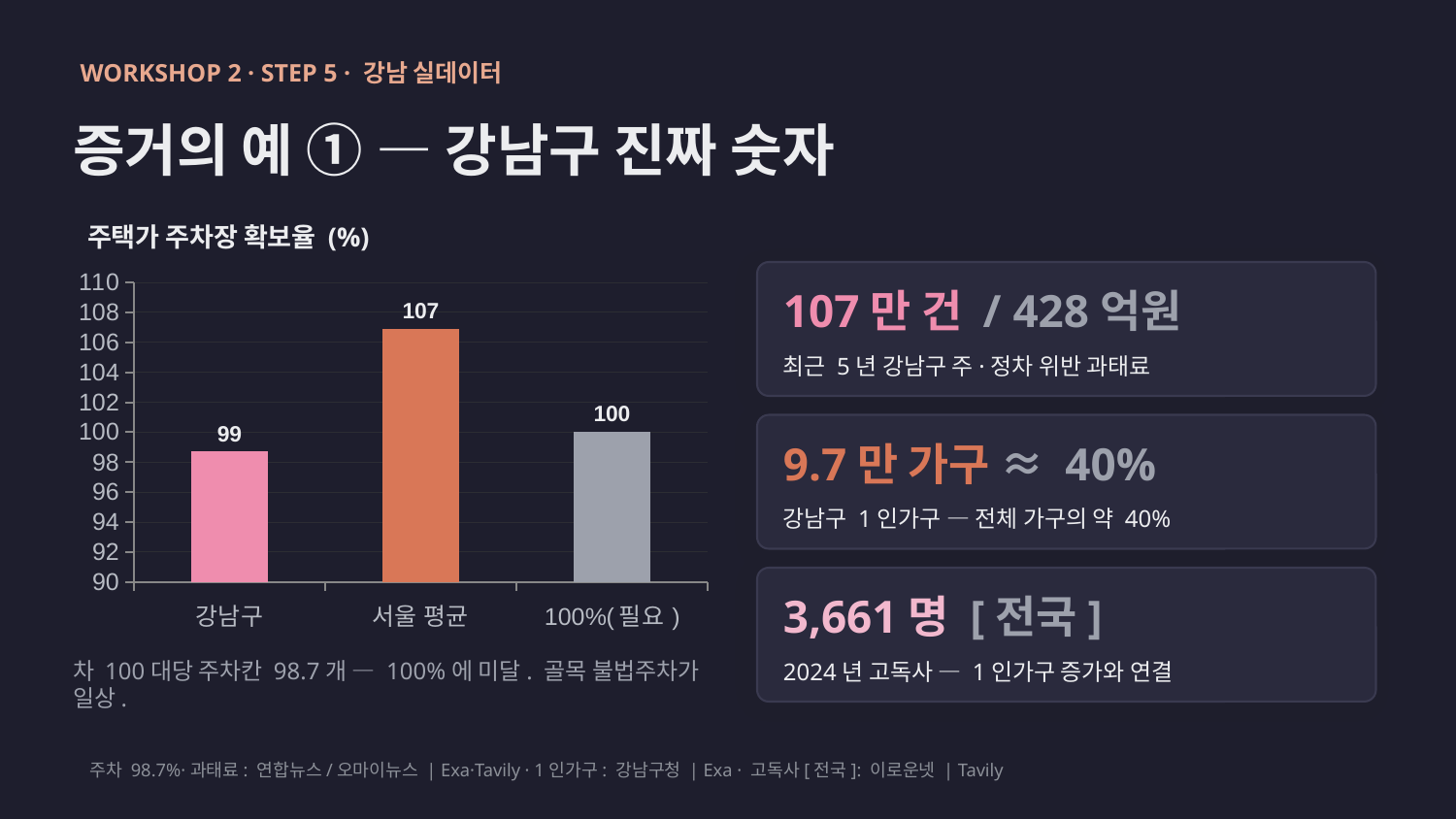
Is the value for 서울 평균 greater or less than 104? greater What colour is the bar for 서울 평균? orange Which category has the highest value in the chart? 서울 평균 What is the value for 서울 평균 in the chart? 107 Which category has the lowest value in the chart? 강남구 What is the difference between the values for 서울 평균 and 강남구? 8 Which is larger, the value for 강남구 or the value for 100%(필요)? 100%(필요) What is the title of the chart? 주택가 주차장 확보율 (%) How many categories are shown in the chart? 3 What is the value for 강남구 in the chart? 99 What type of chart is shown on the slide? bar chart What is the value for 100%(필요) in the chart? 100